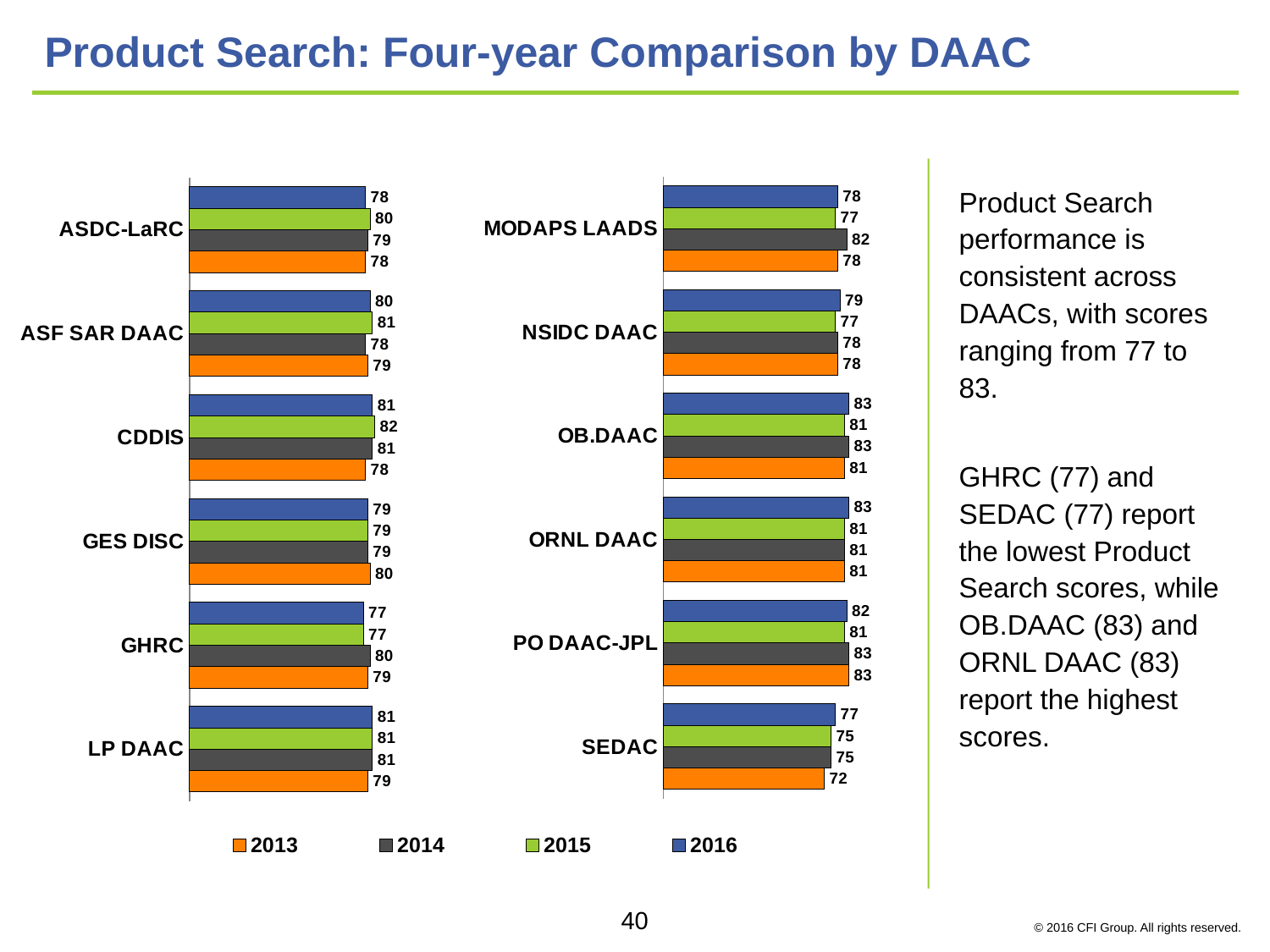
In the right chart, what is the 2016 value for PO DAAC-JPL? 82 In the left chart, what is the 2015 value for CDDIS? 82 In the right chart, what is the difference between the 2014 and 2015 values for MODAPS LAADS? 5 Which year does the orange series in the legend represent? 2013 In the left chart, what is the 2014 value for GHRC? 80 In the left chart, which DAAC has the lowest 2016 value? GHRC How many DAACs are shown in the left chart? 6 In the left chart, is the 2013 value for GES DISC larger or smaller than the 2013 value for CDDIS? larger In the right chart, which DAAC has the lowest 2013 value? SEDAC In the right chart, what is the 2013 value for SEDAC? 72 What kind of chart is shown on the slide? bar chart How many series does the legend list? 4